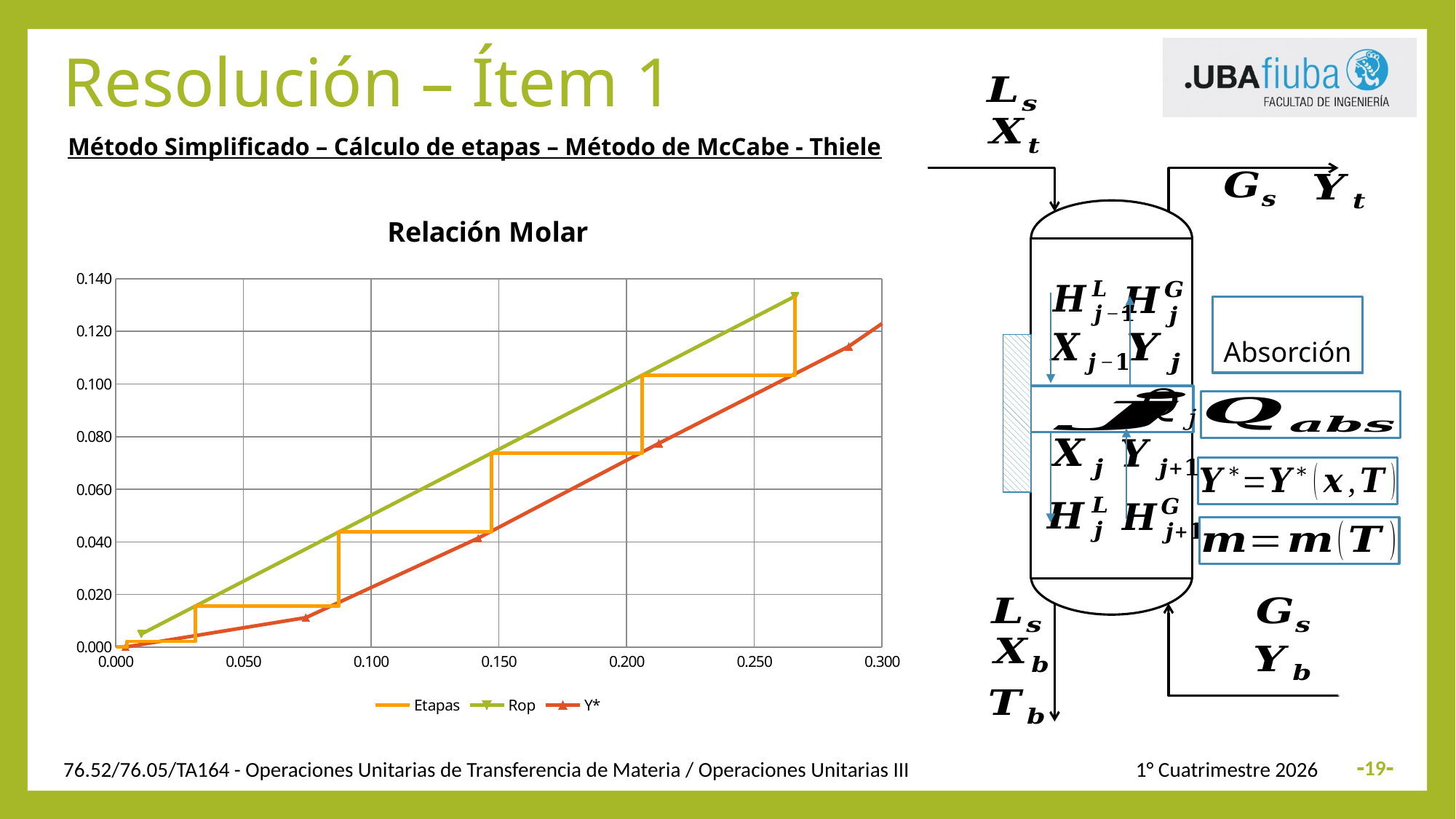
Does the Rop series rise or fall as the x value increases? Rises Is the value of the Y* series at x = 0.200 greater or less than 0.080? less Does the Y* series rise or fall as the x value increases? Rises At x = 0.200, which series has the larger value, Rop or Y*? Rop What are the names of the series listed in the chart legend? Etapas, Rop, Y* What kind of chart is shown on the slide? Line chart What is the title of the chart? Relación Molar Is the value of the Rop series at x = 0.150 greater or less than 0.060? greater Is the value of the Y* series at x = 0.100 greater or less than 0.040? less Which series reaches the highest value on the chart? Rop How many series does the chart legend list? 3 What is the highest value shown on the y axis of the chart? 0.140